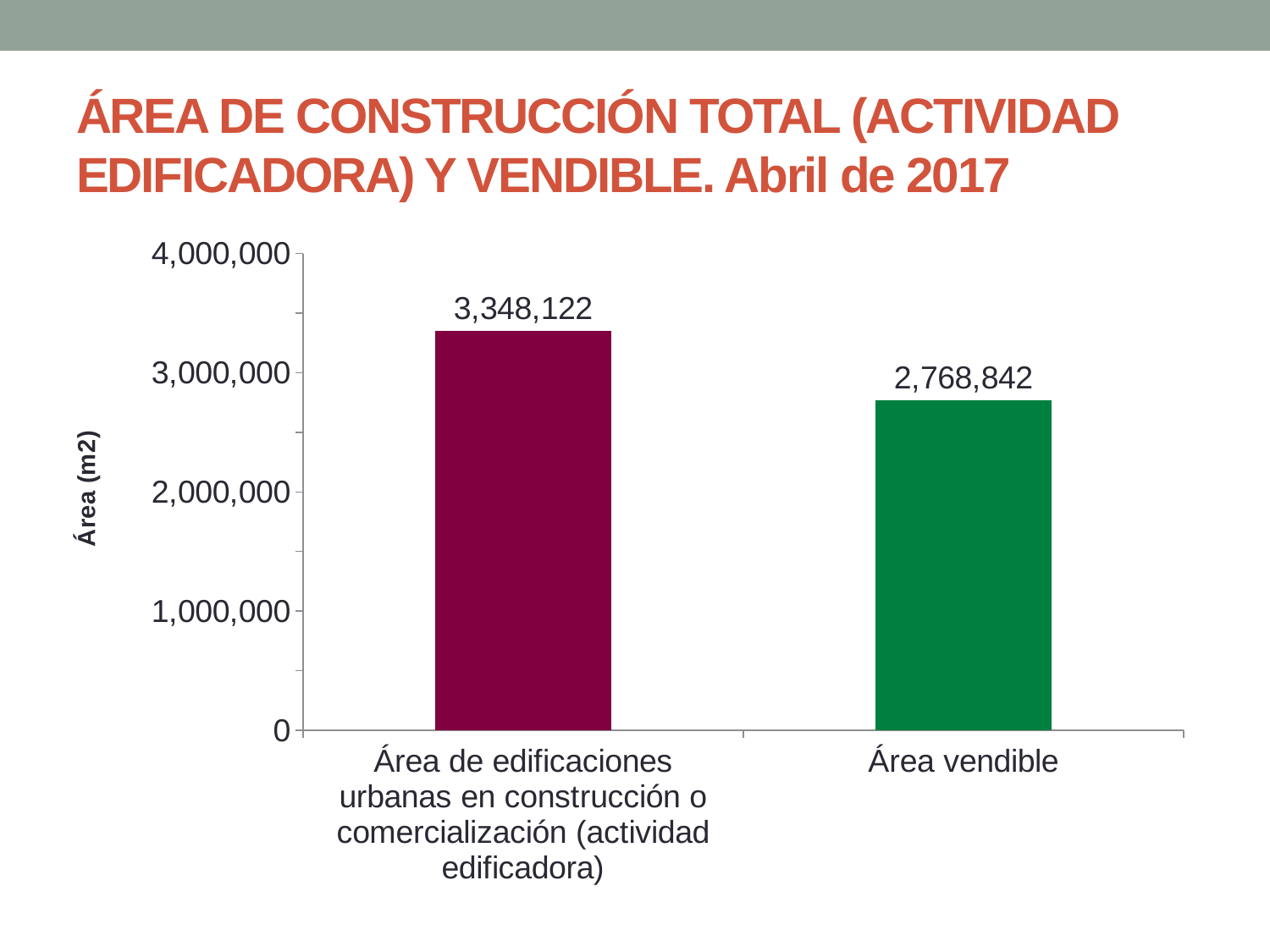
What kind of chart is shown on the slide? Bar chart Which is larger, the value for Área vendible or the value for actividad edificadora? Actividad edificadora What is the difference between the value for actividad edificadora and the value for Área vendible? 579,280 How many categories are shown in the chart? 2 What is the value for Área de edificaciones urbanas en construcción o comercialización (actividad edificadora)? 3,348,122 What is the label of the vertical axis? Área (m2) Which category has the highest value? Área de edificaciones urbanas en construcción o comercialización (actividad edificadora) What is the value for Área vendible? 2,768,842 Is the value for Área vendible greater or less than 3,000,000? less Is the value for actividad edificadora greater or less than 3,000,000? greater What colour is the bar for Área vendible? Green Which category has the lowest value? Área vendible